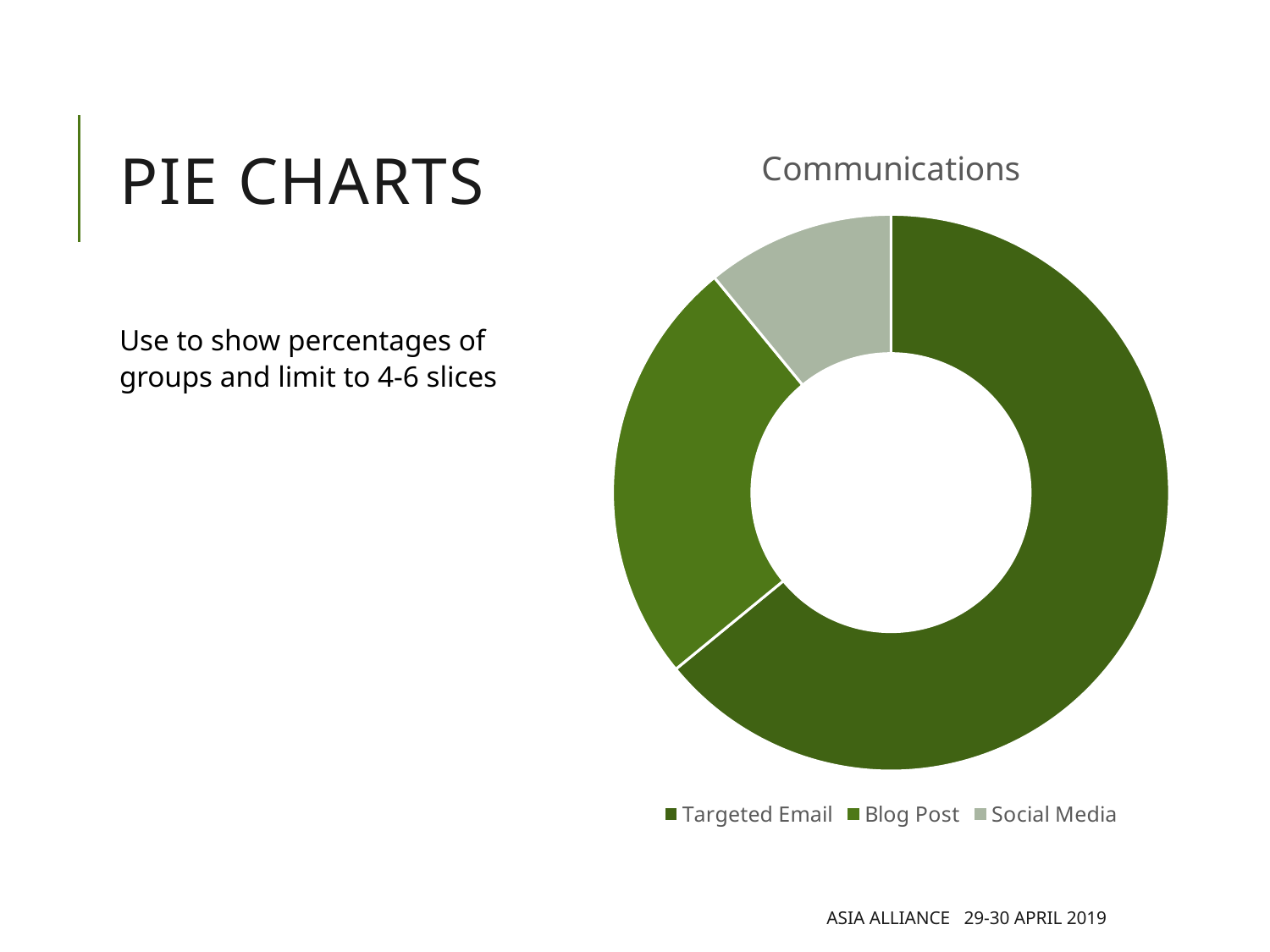
How many slices does the Communications chart have? 3 What kind of chart is shown on the slide? doughnut chart Which category has the largest slice in the Communications chart? Targeted Email How many entries does the legend of the Communications chart list? 3 Does the Targeted Email slice take up more or less than half of the Communications chart? more What is the title of the chart? Communications What are the three categories listed in the legend of the Communications chart? Targeted Email, Blog Post, Social Media Which slice is larger in the Communications chart, Targeted Email or Blog Post? Targeted Email Which slice is larger in the Communications chart, Blog Post or Social Media? Blog Post Which category has the smallest slice in the Communications chart? Social Media